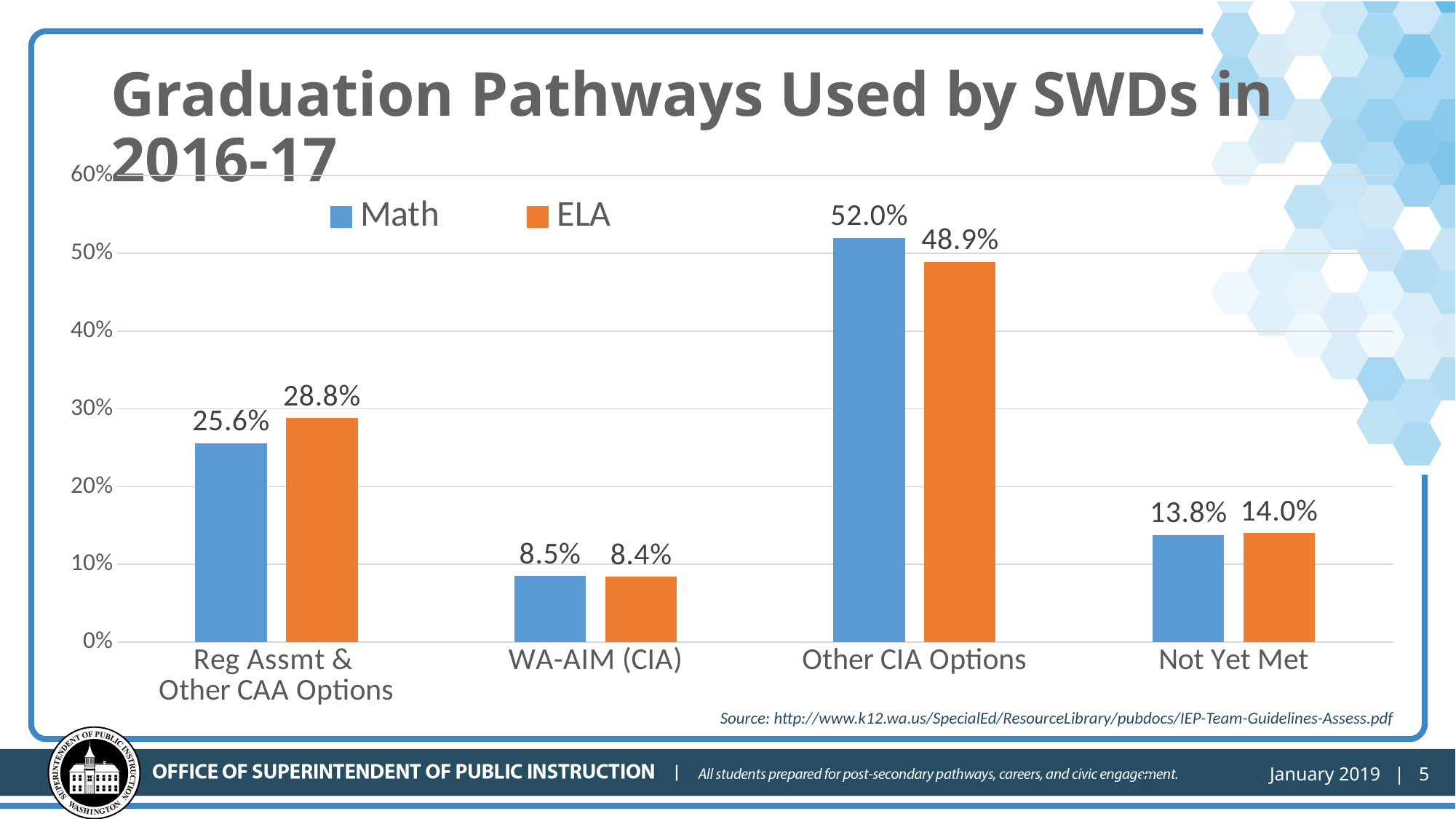
How many series does the legend list? 2 For Reg Assmt & Other CAA Options, which series has the larger value, Math or ELA? ELA Is the Math value for Not Yet Met greater or less than 20%? less Which category has the highest Math value? Other CIA Options What is the ELA value for Reg Assmt & Other CAA Options? 28.8% How many categories are shown on the x axis? 4 What is the ELA value for Not Yet Met? 14.0% What is the difference between the Math and ELA values for Other CIA Options? 3.1% Which category has the lowest ELA value? WA-AIM (CIA) What kind of chart is shown on the slide? Bar chart What is the Math value for WA-AIM (CIA)? 8.5% What is the Math value for Other CIA Options? 52.0%